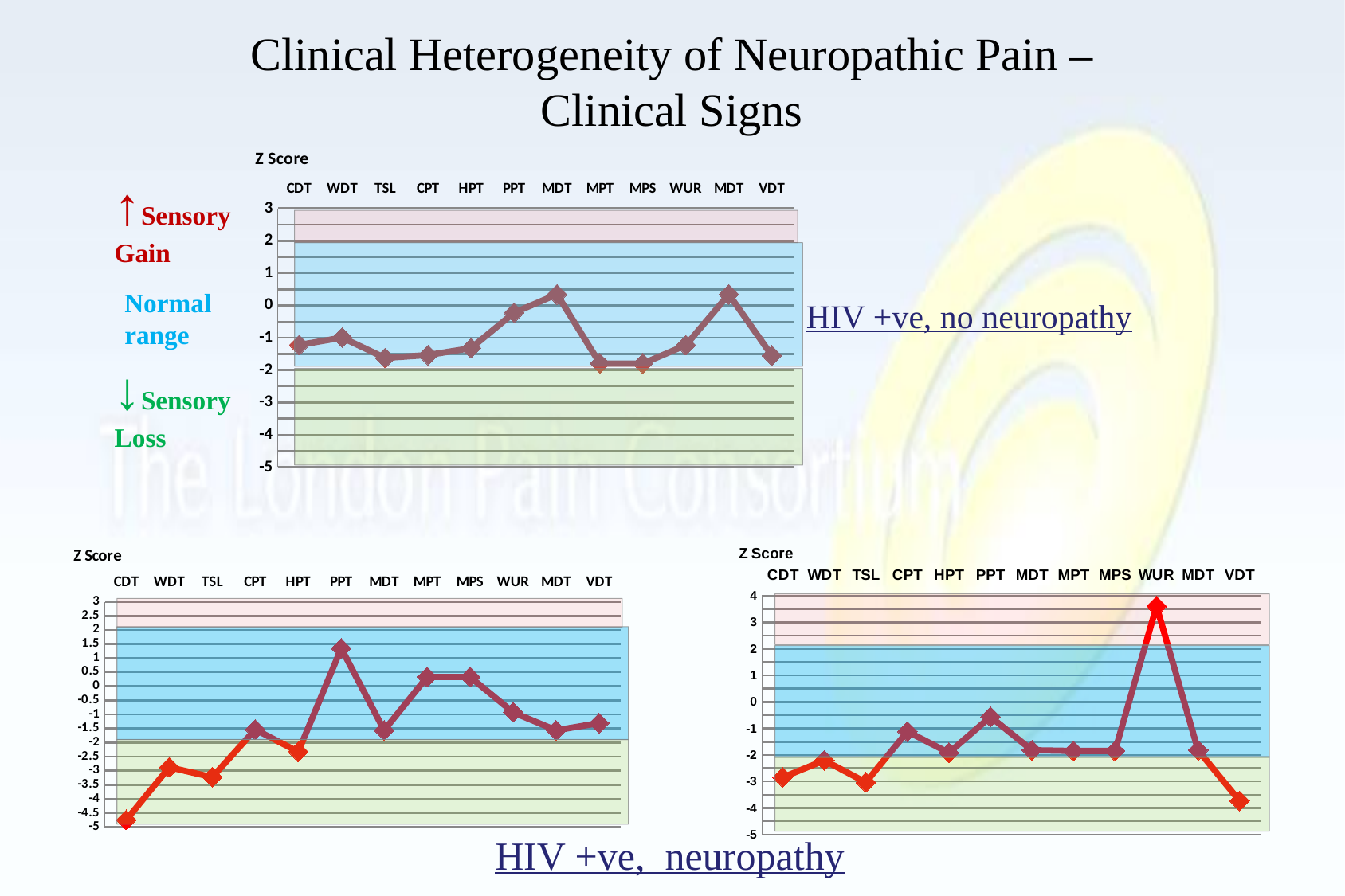
In the bottom-right chart, which is larger, the value for CPT or the value for TSL? CPT In the top chart (HIV +ve, no neuropathy), is the value for PPT greater or less than -1? greater In the bottom-right chart, is the value for WUR greater or less than 3? greater How many charts are shown on the slide? 3 In the top chart (HIV +ve, no neuropathy), how many categories are plotted along the x axis? 12 In the bottom-left chart, is the value for CDT greater or less than -4? less What kind of chart is the top chart labelled 'HIV +ve, no neuropathy'? line chart In the bottom-left chart, which category has the highest Z score? PPT In the bottom-left chart, which category has the lowest Z score? CDT In the bottom-right chart, which category has the lowest Z score? VDT In the bottom-right chart, which category has the highest Z score? WUR